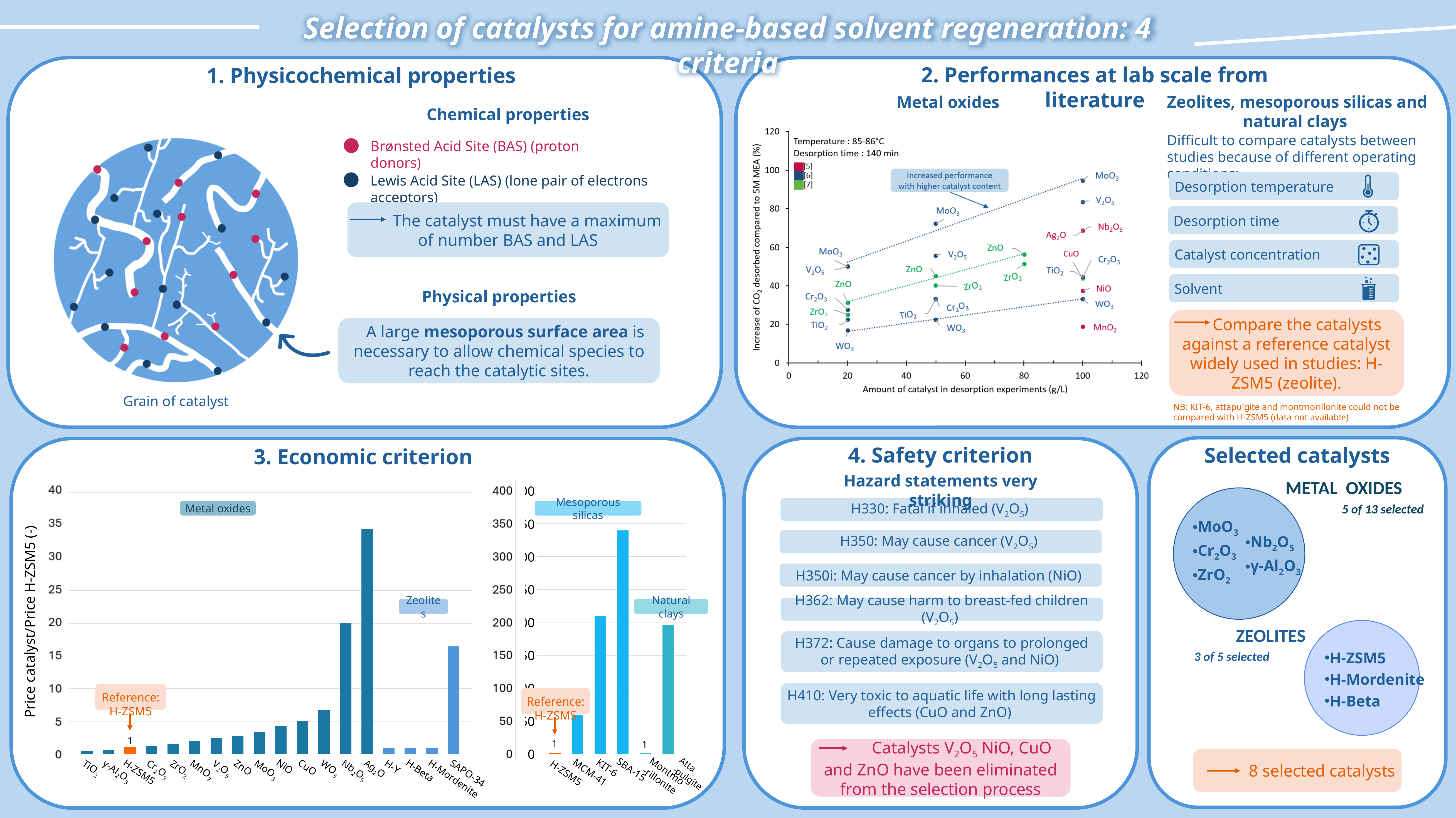
In the right bar chart of the '3. Economic criterion' section, what value is labelled for Montmorillonite? 1 In the left bar chart of the '3. Economic criterion' section, what is the value shown for H-ZSM5? 1 In the right bar chart of the '3. Economic criterion' section, how many catalysts are shown on the x axis? 6 In the left bar chart of the '3. Economic criterion' section, which catalyst has the highest price ratio? Ag2O In the left bar chart of the '3. Economic criterion' section, which has the larger price ratio, Nb2O5 or SAPO-34? Nb2O5 In the right bar chart of the '3. Economic criterion' section, is the value for SBA-15 greater or less than 300? greater In the 'Metal oxides' scatter chart of section 2, how many references does the legend list? 3 In the right bar chart of the '3. Economic criterion' section, which catalyst has the highest bar? SBA-15 In the 'Metal oxides' scatter chart of section 2, what is the label of the y axis? Increase of CO2 desorbed compared to 5M MEA (%) In the left bar chart of the '3. Economic criterion' section, is the value for Ag2O greater or less than 30? greater In the left bar chart of the '3. Economic criterion' section, how many catalysts are shown on the x axis? 18 What kind of chart is the left chart in the '3. Economic criterion' section? bar chart